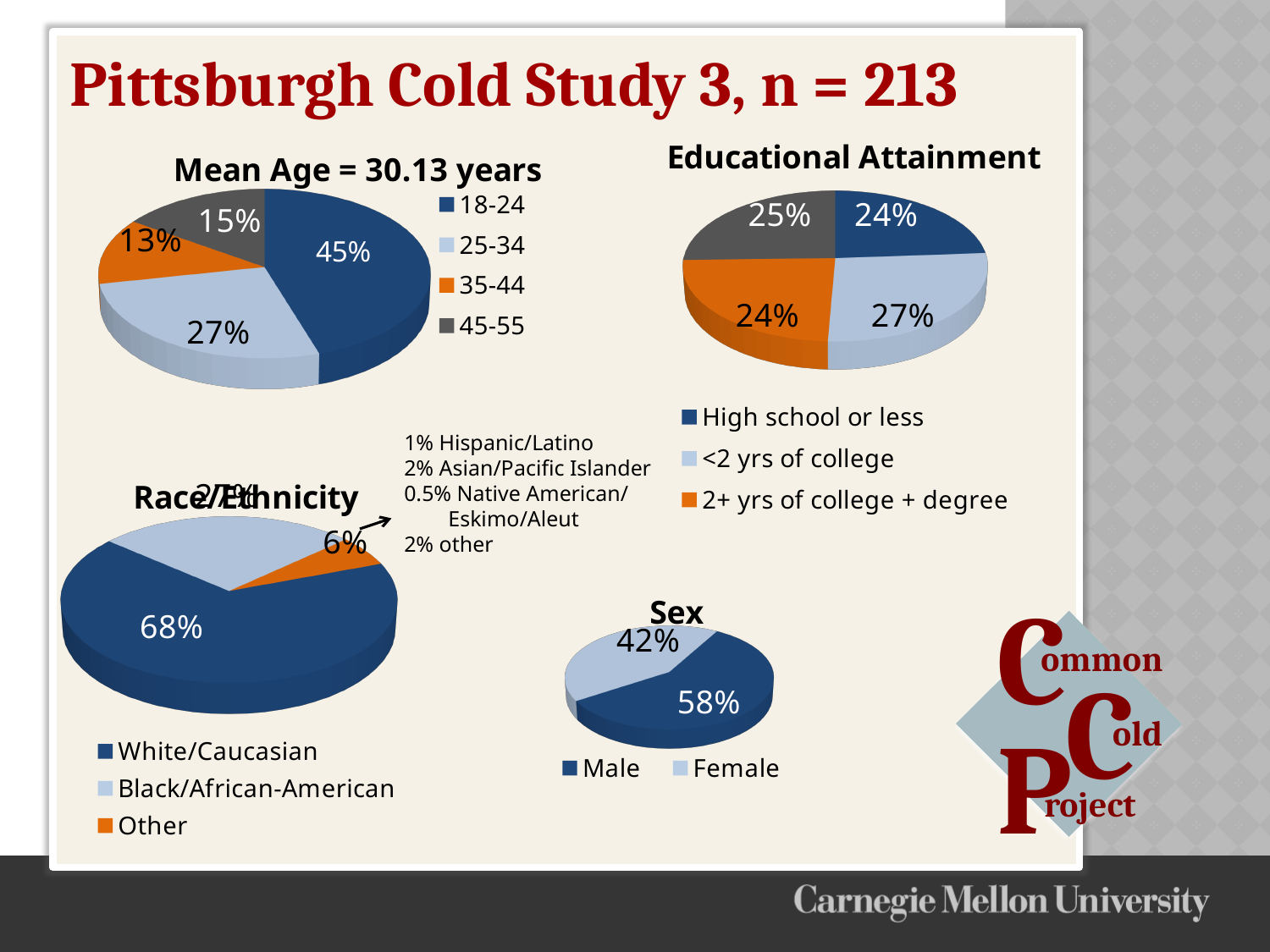
How many age groups does the legend of the Mean Age = 30.13 years chart list? 4 In the Race/Ethnicity pie chart, what percentage is shown for White/Caucasian? 68% In the Mean Age = 30.13 years pie chart, which age group has the largest share? 18-24 In the Sex pie chart, what is the difference in percentage points between Male and Female? 16 In the Mean Age = 30.13 years pie chart, what percentage is shown for the 18-24 age group? 45% In the Mean Age = 30.13 years pie chart, what is the difference in percentage points between the 25-34 and 45-55 groups? 12 In the Educational Attainment pie chart, what percentage is shown for <2 yrs of college? 27% In the Educational Attainment pie chart, what percentage is shown for High school or less? 24% In the Mean Age = 30.13 years pie chart, which age group has the smallest share? 35-44 In the Sex pie chart, which is larger, Male or Female? Male How many slices does the Educational Attainment pie chart have? 4 In the Race/Ethnicity pie chart, what percentage is shown for Other? 6%